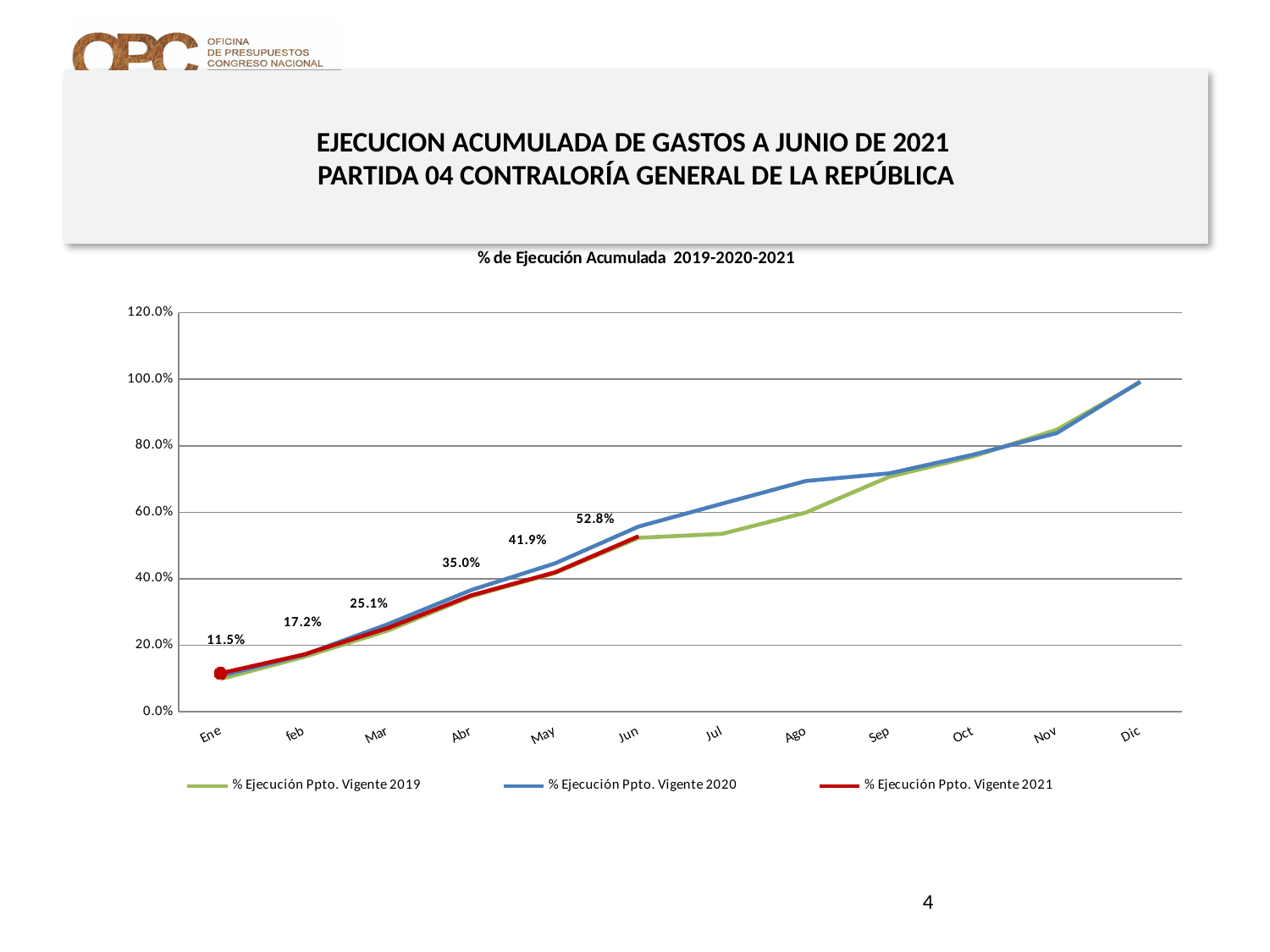
In Ago, which series has the larger value: % Ejecución Ppto. Vigente 2019 or % Ejecución Ppto. Vigente 2020? % Ejecución Ppto. Vigente 2020 Is the value for % Ejecución Ppto. Vigente 2020 in Ago greater or less than 60.0%? greater How many series does the legend list? 3 Does the % Ejecución Ppto. Vigente 2021 series rise or fall from Ene to Jun? rise What is the value for % Ejecución Ppto. Vigente 2021 in Ene? 11.5% What is the difference between the % Ejecución Ppto. Vigente 2021 values for Jun and May? 10.9% What is the value for % Ejecución Ppto. Vigente 2021 in Mar? 25.1% What is the value for % Ejecución Ppto. Vigente 2021 in Jun? 52.8% How many months are shown on the x axis? 12 Which month has the highest value for % Ejecución Ppto. Vigente 2021? Jun What is the title of the chart? % de Ejecución Acumulada 2019-2020-2021 What type of chart is shown on the slide? line chart